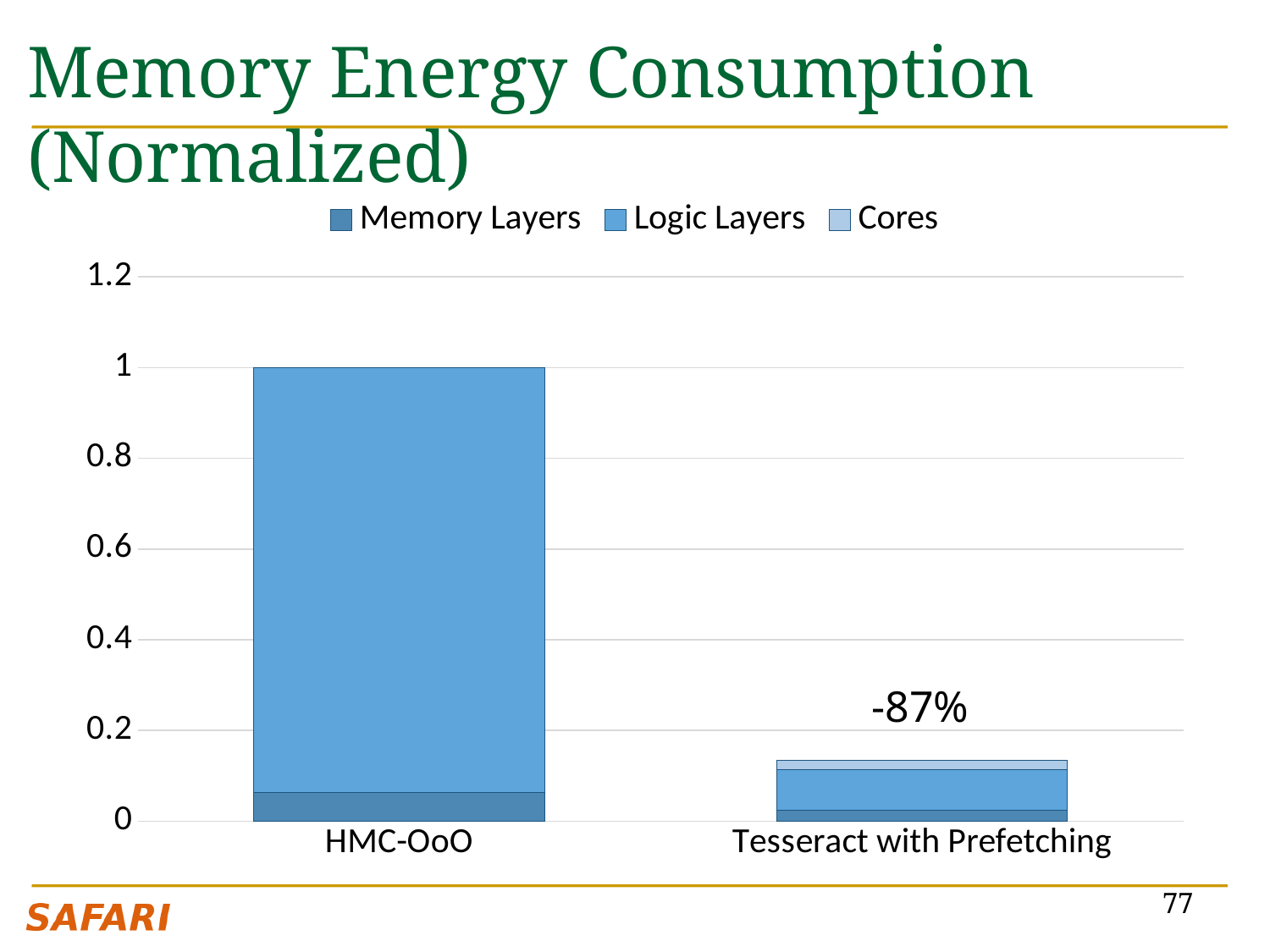
Is the total value for HMC-OoO greater or less than 0.8? greater What are the three series listed in the chart's legend? Memory Layers, Logic Layers, Cores Which has a larger total normalized memory energy consumption, HMC-OoO or Tesseract with Prefetching? HMC-OoO What percentage change is annotated above the Tesseract with Prefetching bar? -87% How many categories are shown on the x axis of the chart? 2 What is the title of the chart on the slide? Memory Energy Consumption (Normalized) How many series does the chart's legend list? 3 Which category has the highest total normalized memory energy consumption? HMC-OoO What kind of chart is shown on the slide? bar chart Which category has the lowest total normalized memory energy consumption? Tesseract with Prefetching Is the total value for Tesseract with Prefetching greater or less than 0.2? less What is the total height of the stacked bar for HMC-OoO? 1